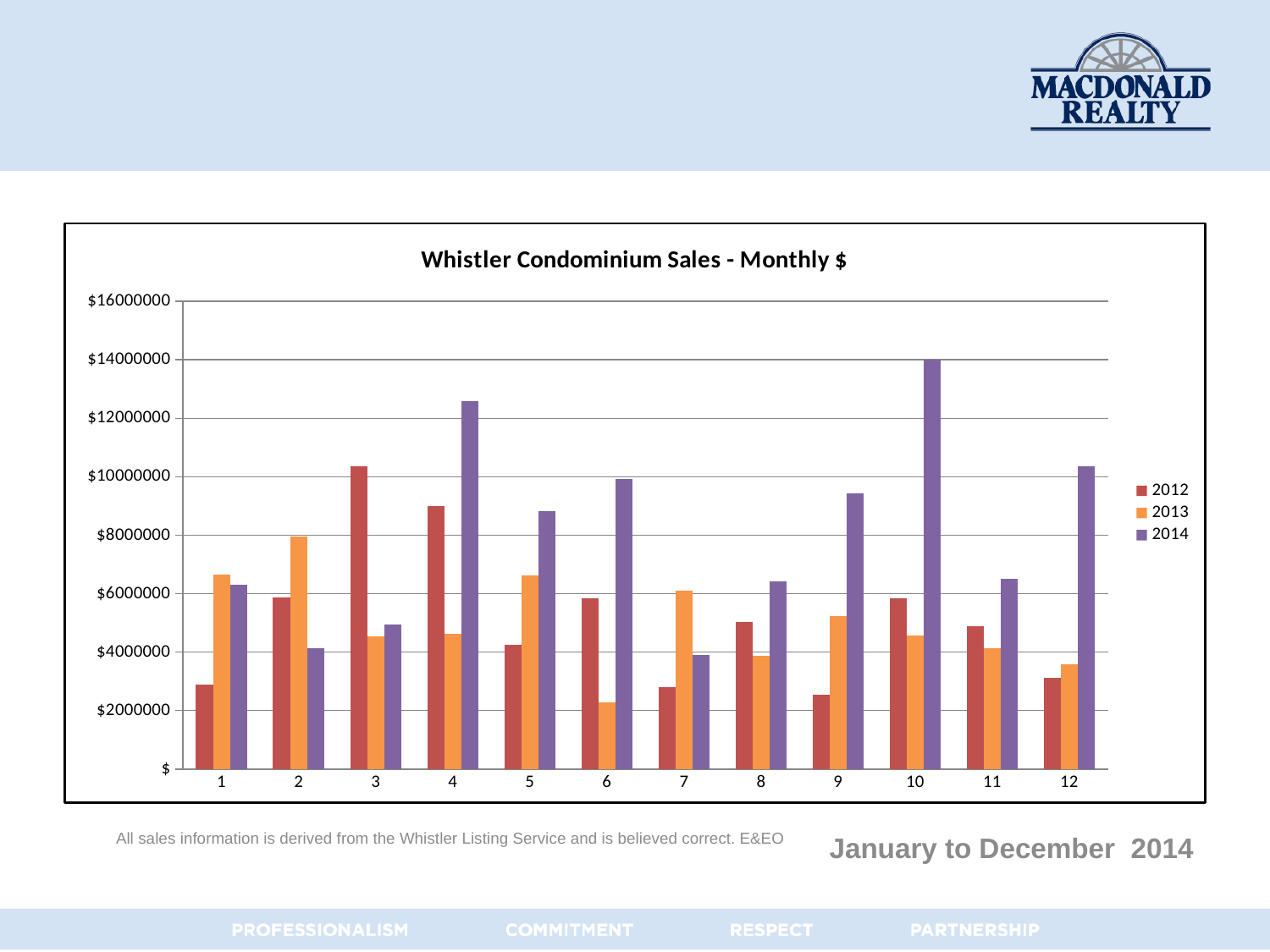
Which colour represents the 2014 series in the legend? Purple What is the title of the chart? Whistler Condominium Sales - Monthly $ What kind of chart is shown on the slide? Bar chart In which month does the 2012 series reach its highest value? 3 Is the 2013 value for month 6 greater or less than $4000000? less In which month does the 2013 series reach its highest value? 2 In which month does the 2013 series have its lowest value? 6 How many series does the legend list? 3 Is the 2014 value for month 4 greater or less than $12000000? greater In which month does the 2014 series reach its highest value? 10 How many months (categories) are shown on the x axis? 12 In month 2, which series has the larger value, 2013 or 2014? 2013